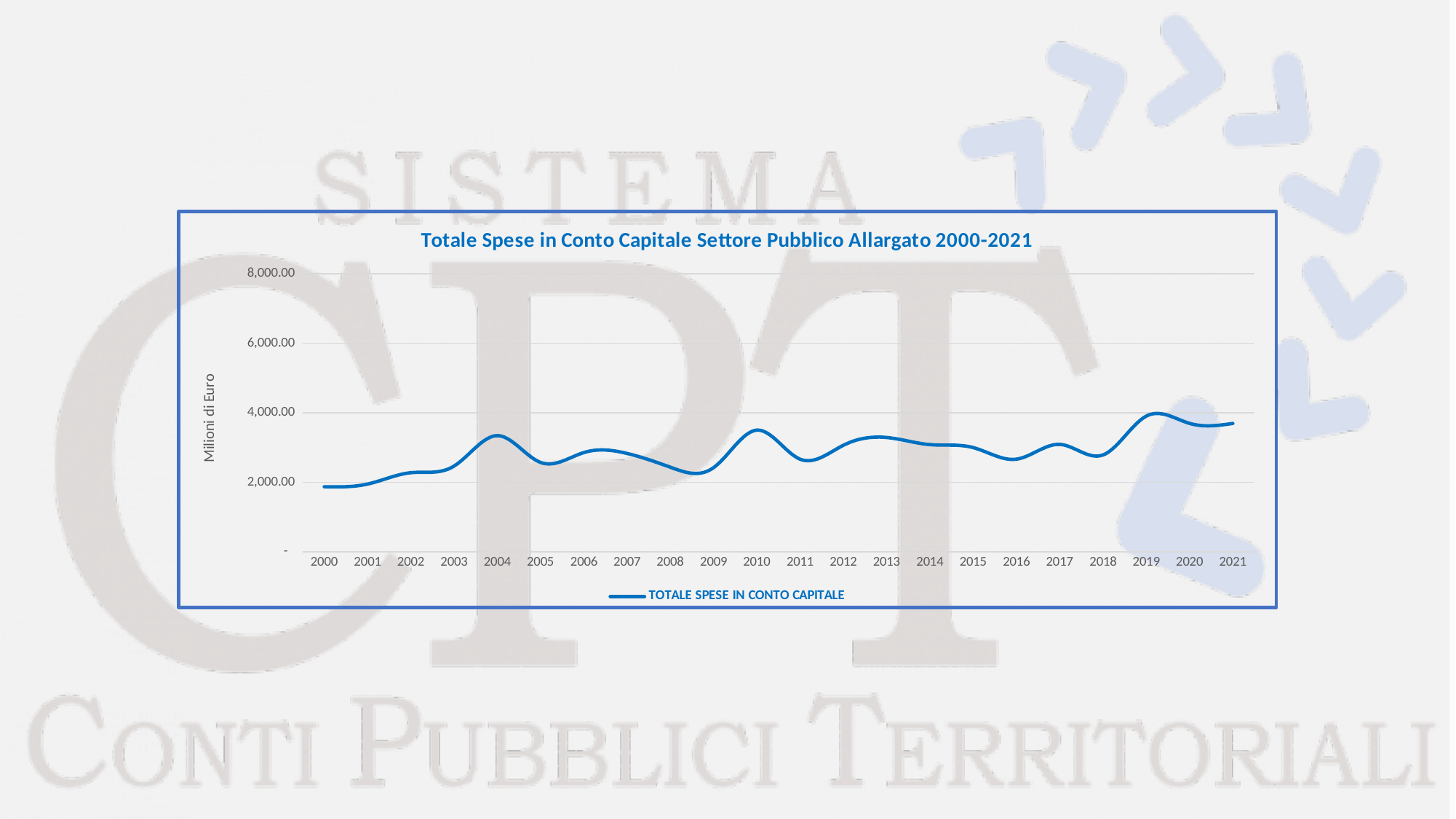
How many series does the legend list? 1 Which year has the larger value, 2010 or 2011? 2010 What is the title of the chart? Totale Spese in Conto Capitale Settore Pubblico Allargato 2000-2021 Is the value for 2004 greater or less than 4,000.00? less Which year has the larger value, 2004 or 2005? 2004 Is the value for 2021 greater or less than 2,000.00? greater Overall, does the line rise or fall from 2000 to 2021? rise Is the value for 2010 greater or less than 6,000.00? less What is the label of the series in the legend? TOTALE SPESE IN CONTO CAPITALE How many years are plotted along the x axis? 22 What kind of chart is shown on the slide? line chart Which year has the highest value on the line? 2019